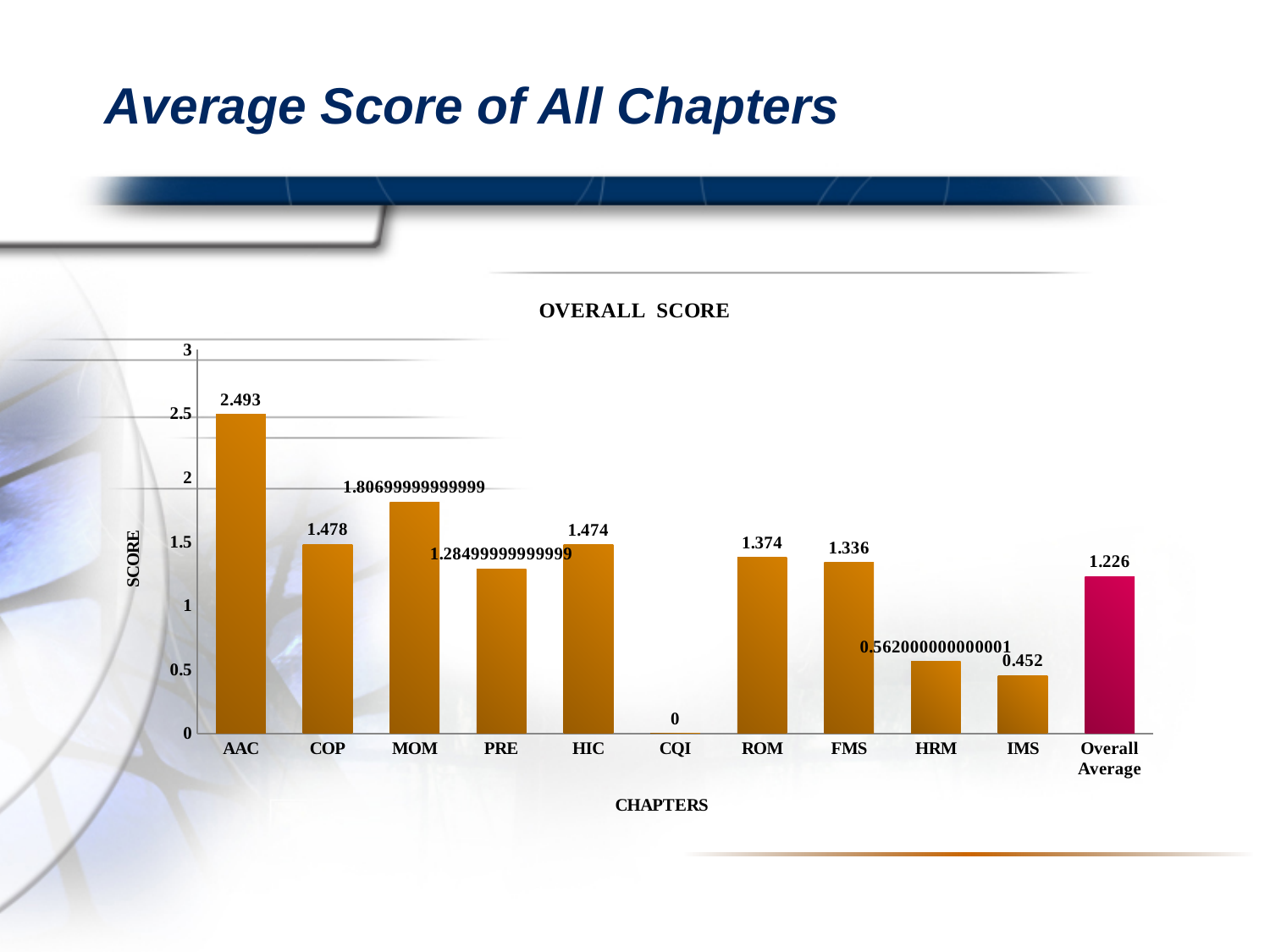
How many bars are shown on the chart? 11 What is the score for IMS? 0.452 Which chapter has the highest score? AAC Is the value for MOM greater or less than 1.5? greater What is the score for AAC? 2.493 Which has a higher score, ROM or FMS? ROM What is the value shown for Overall Average? 1.226 What is the title of the chart? OVERALL SCORE What is the difference between the scores for AAC and COP? 1.015 What kind of chart is shown on the slide? Bar chart What is the score for ROM? 1.374 Which chapter has the lowest score? CQI